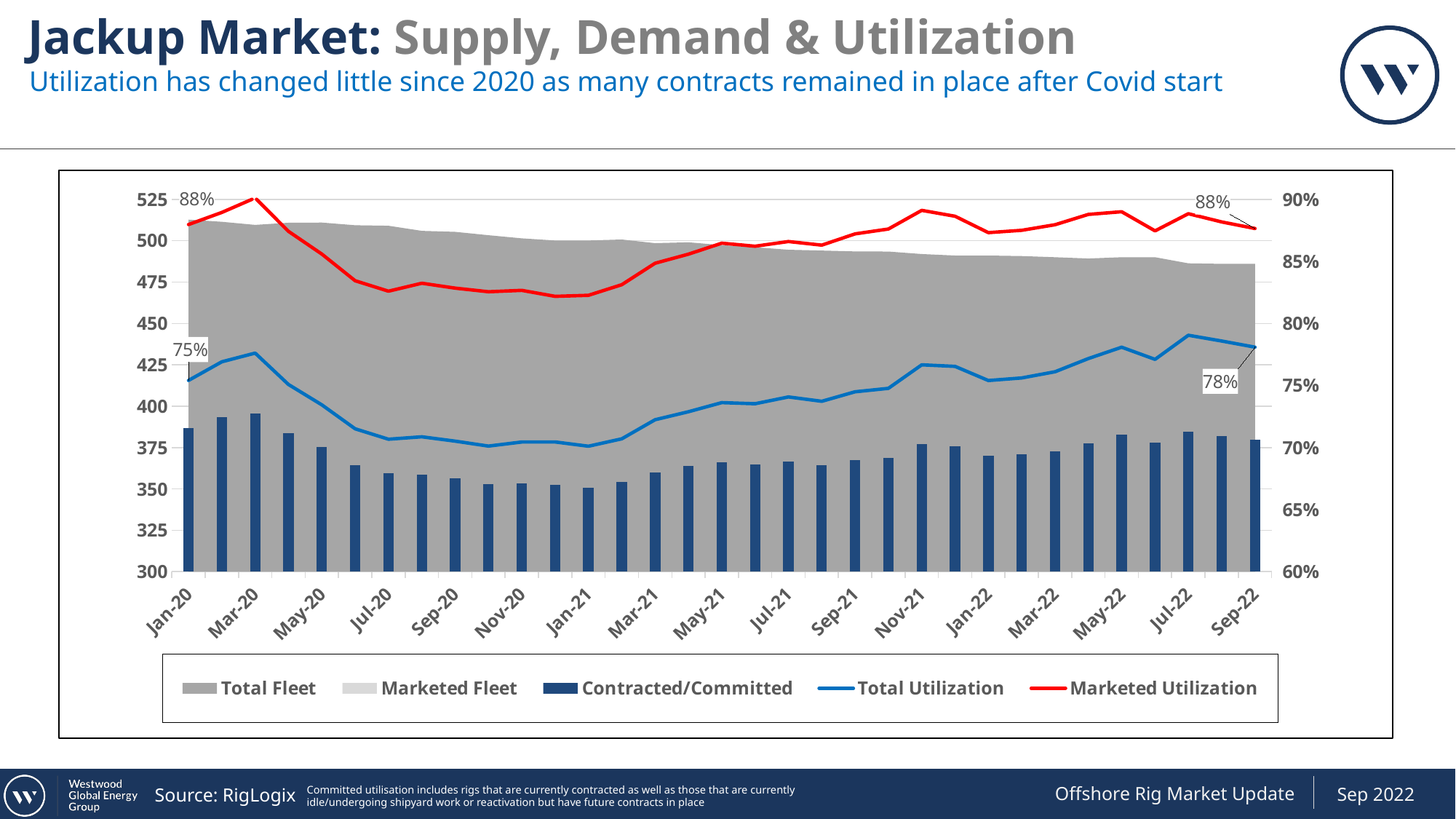
At Sep-22, which is higher: Marketed Utilization or Total Utilization? Marketed Utilization In which month does the Marketed Utilization line reach its highest point? Mar-20 How many series does the legend list? 5 What is the Total Utilization value labelled for Sep-22? 78% Is the Marketed Utilization value for Jul-20 greater or less than 85%? less What colour is the Marketed Utilization line? Red What is the Total Utilization value labelled for Jan-20? 75% What is the Marketed Utilization value labelled for Jan-20? 88% Is the Contracted/Committed value for Jan-21 greater or less than 375? less Does the Total Fleet area rise or fall from Jan-20 to Sep-22? fall Is the Total Fleet value for Jan-20 greater or less than 500? greater By how many percentage points did Total Utilization change between the labelled Jan-20 and Sep-22 values? 3 percentage points